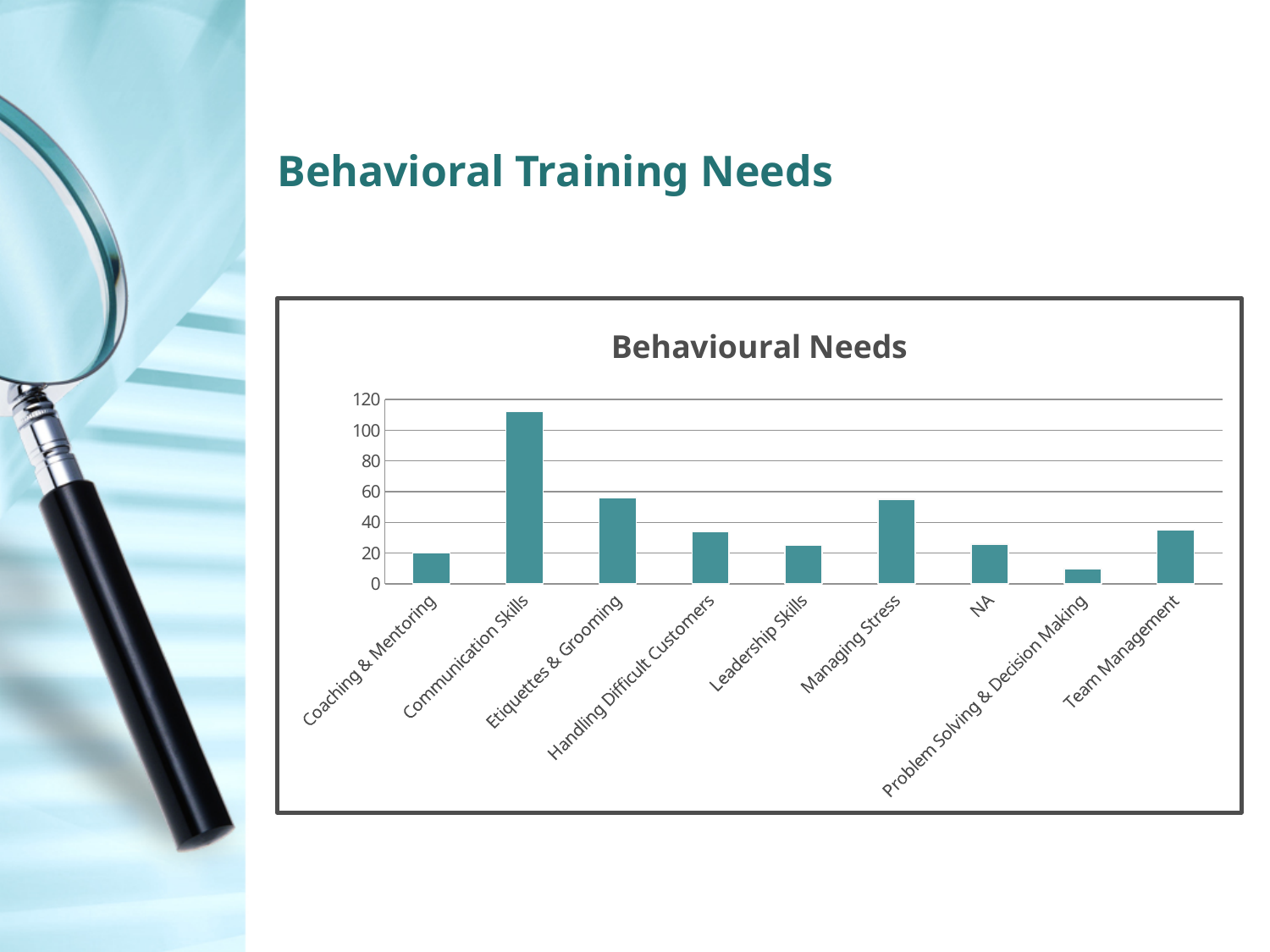
What kind of chart is shown on the slide? Bar chart How many categories are shown on the x axis of the chart? 9 Which category has the lowest value in the chart? Problem Solving & Decision Making Which is larger, the value for Coaching & Mentoring or the value for Problem Solving & Decision Making? Coaching & Mentoring Is the value for Communication Skills greater or less than 100? greater Which is larger, the value for Communication Skills or the value for Etiquettes & Grooming? Communication Skills Is the value for Managing Stress greater or less than 40? greater Is the value for Team Management greater or less than 40? less Which category has the highest value in the chart? Communication Skills What is the title of the chart? Behavioural Needs